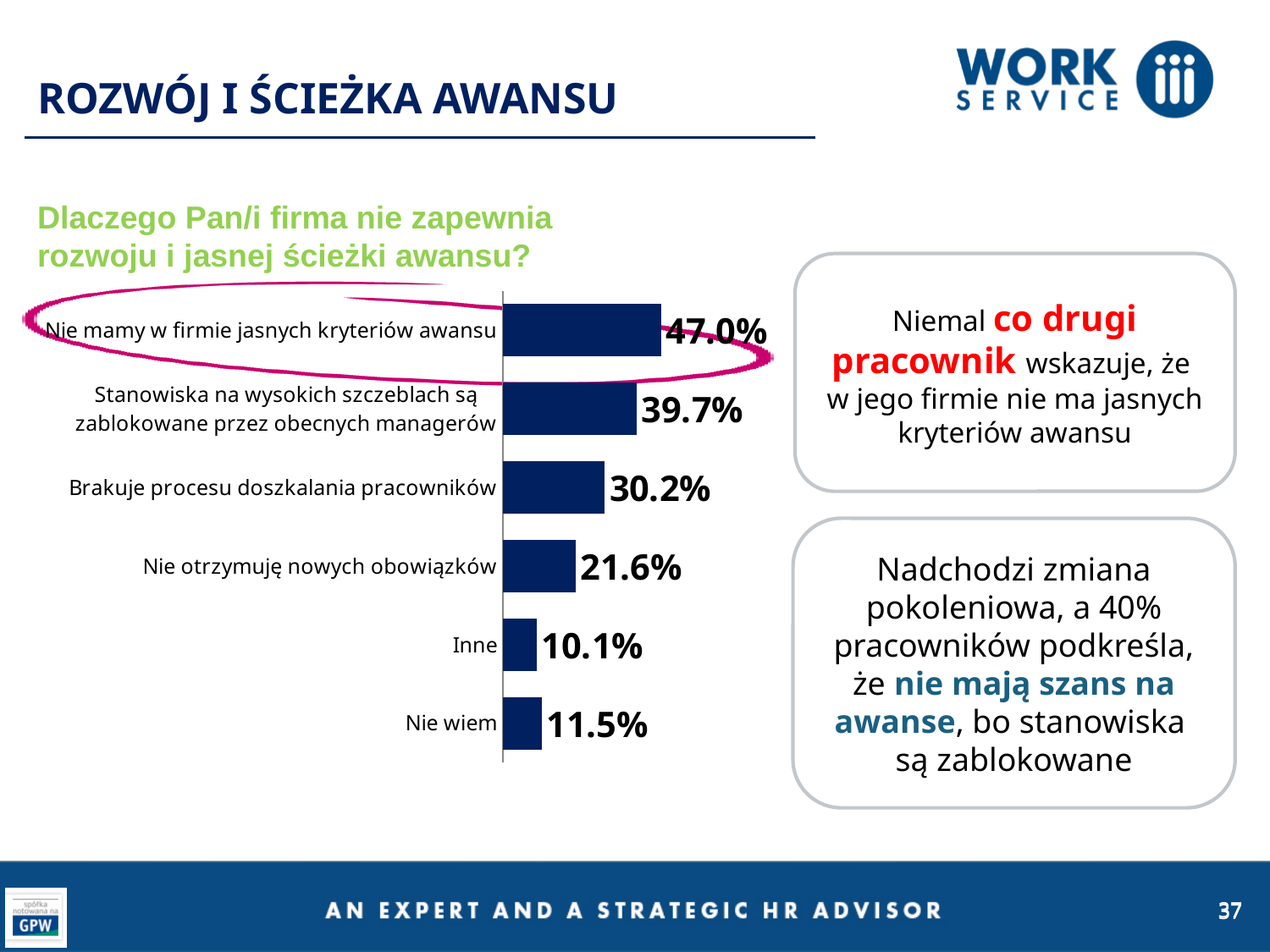
What is the difference between 'Nie mamy w firmie jasnych kryteriów awansu' and 'Stanowiska na wysokich szczeblach są zablokowane przez obecnych managerów'? 7.3% What is the value for 'Inne'? 10.1% What is the value for 'Brakuje procesu doszkalania pracowników'? 30.2% What question is the chart answering, as written above it? Dlaczego Pan/i firma nie zapewnia rozwoju i jasnej ścieżki awansu? Which category has the lowest value? Inne What kind of chart is shown on the slide? Bar chart How many categories does the chart show? 6 What is the value for 'Nie otrzymuję nowych obowiązków'? 21.6% Which category has the highest value? Nie mamy w firmie jasnych kryteriów awansu What is the value for 'Nie wiem'? 11.5% Which is larger: 'Nie wiem' or 'Inne'? Nie wiem What is the value for 'Nie mamy w firmie jasnych kryteriów awansu'? 47.0%